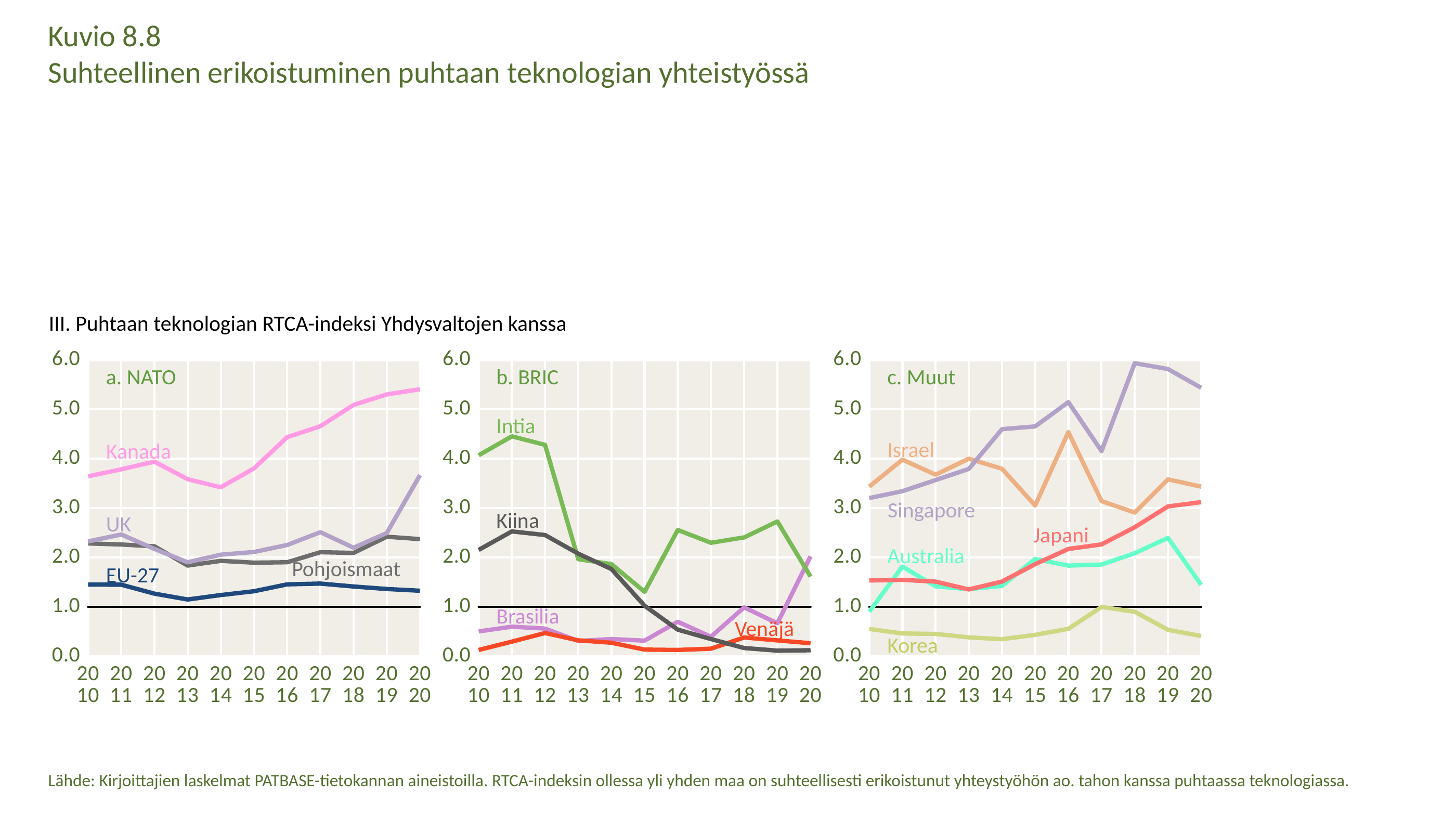
In the 'b. BRIC' chart, does the value for Kiina rise or fall from 2010 to 2020? fall In the 'c. Muut' chart, which series has the lowest value in 2020? Korea In the 'b. BRIC' chart, is the value for Intia in 2011 greater or less than 4.0? greater In the 'a. NATO' chart, is the value for Kanada in 2020 greater or less than 5.0? greater In the 'a. NATO' chart, which series has the lowest value in 2020? EU-27 In the 'c. Muut' chart, is the value for Singapore in 2018 greater or less than 5.0? greater In the 'a. NATO' chart, which series has the highest value in 2020? Kanada What kind of chart is the 'a. NATO' chart? line chart In the 'b. BRIC' chart, which series has the highest value in 2010? Intia In the 'c. Muut' chart, how many series are plotted? 5 In the 'a. NATO' chart, how many series are plotted? 4 In the 'b. BRIC' chart, how many years are shown on the x axis? 11